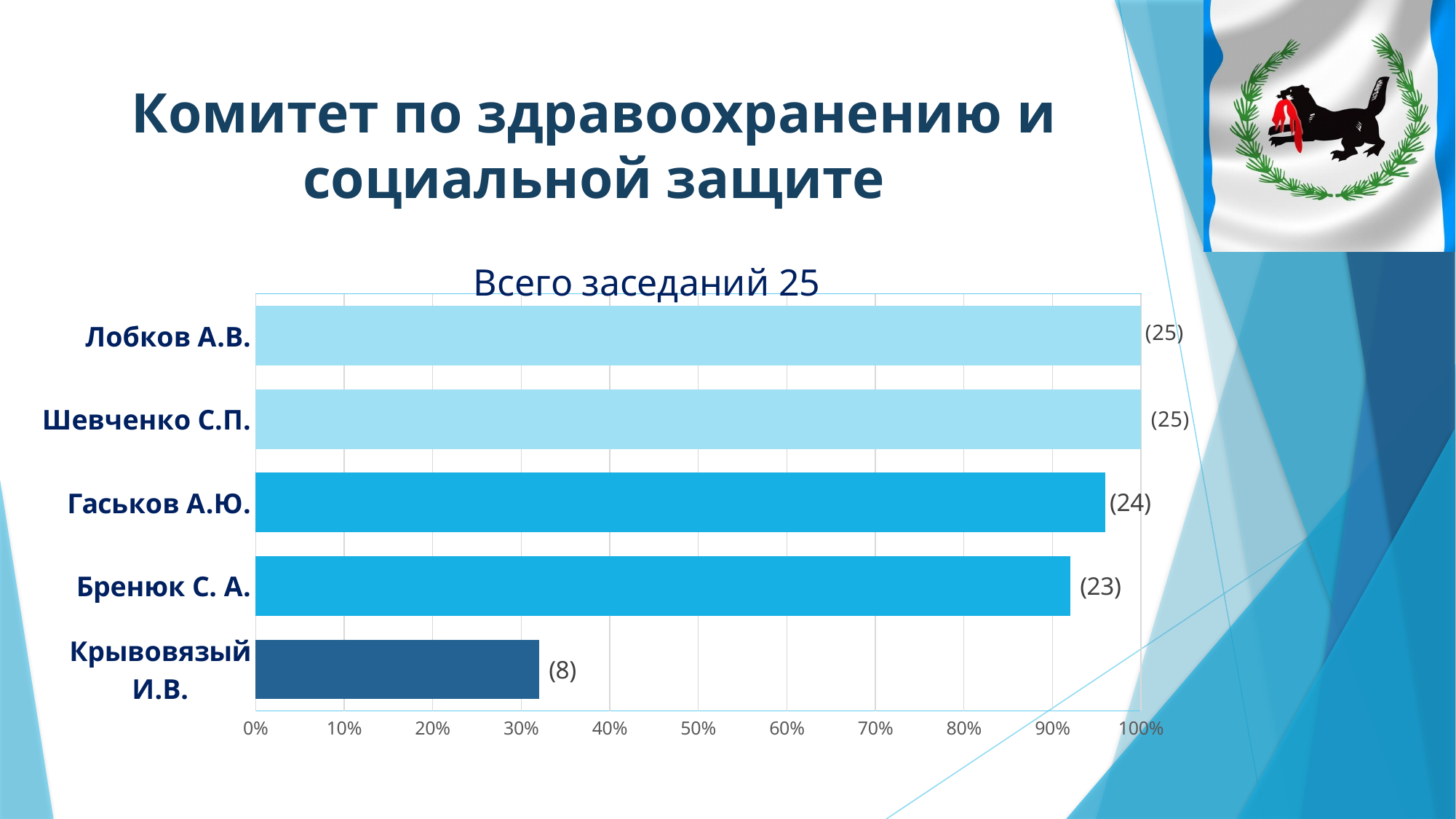
What type of chart is shown on the slide? Bar chart What is the data label shown for Шевченко С.П.? (25) What is the difference between the labelled values for Лобков А.В. and Крывовязый И.В.? 17 Is the bar for Бренюк С. А. greater or less than 80%? greater Which category has the lowest value? Крывовязый И.В. What is the difference between the labelled values for Гаськов А.Ю. and Бренюк С. А.? 1 What is the data label shown for Крывовязый И.В.? (8) How many categories are shown in the chart? 5 What is the data label shown for Бренюк С. А.? (23) Which has a larger value, Гаськов А.Ю. or Бренюк С. А.? Гаськов А.Ю. Is the bar for Крывовязый И.В. greater or less than 40%? less What is the data label shown for Гаськов А.Ю.? (24)